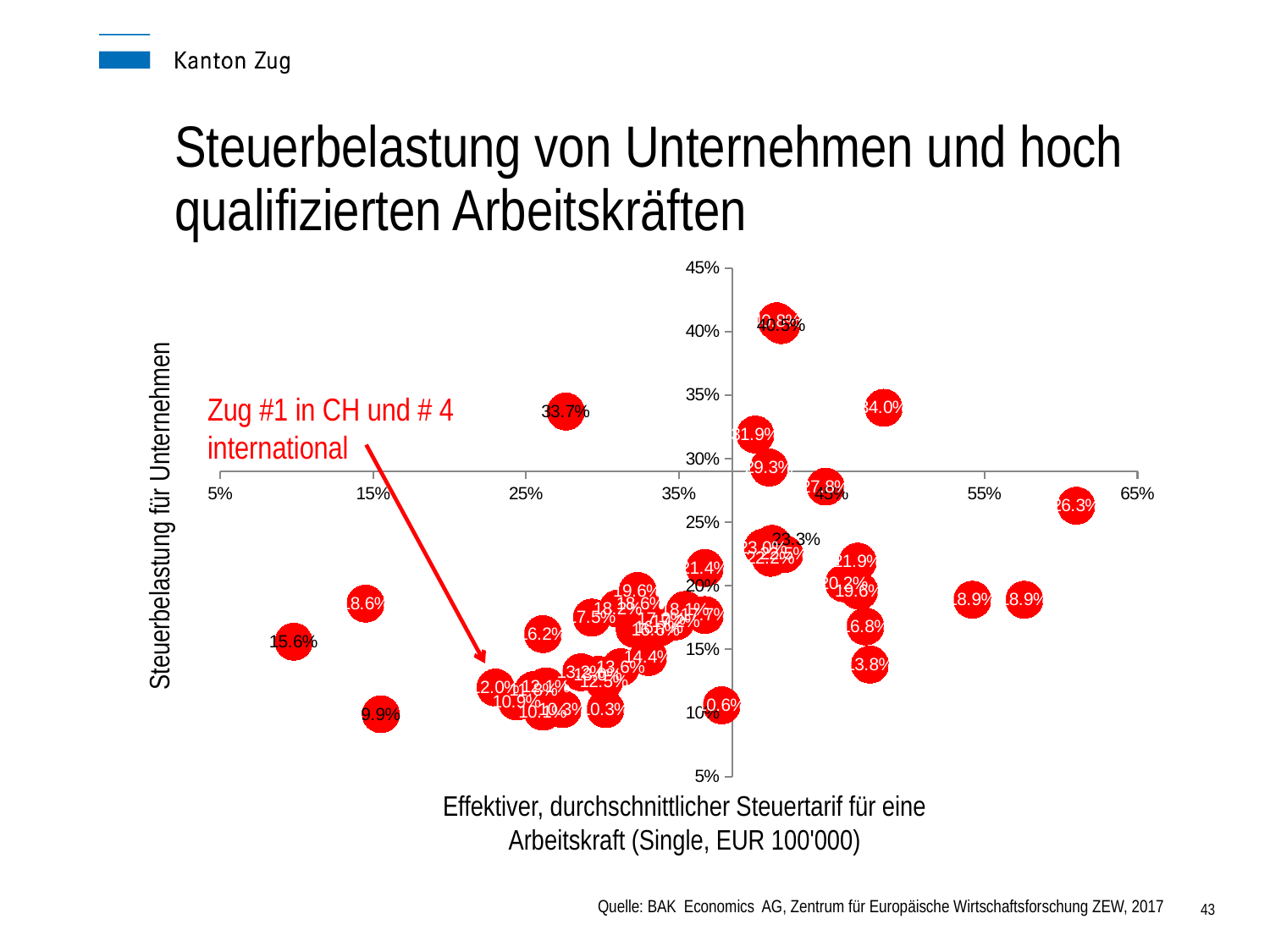
Is the x-axis value of the point labeled 34.0% greater or less than 45%? greater What is the lowest value printed as a data label on the chart? 9.9% Is the x-axis value of the point labeled 26.3% greater or less than 55%? greater What text does the red annotation on the chart say? Zug #1 in CH und # 4 international What is the highest value printed as a data label on the chart? 40.8% What is the title of the vertical axis? Steuerbelastung für Unternehmen What is the highest tick value shown on the vertical axis? 45% Which is larger, the point labeled 33.7% or the point labeled 34.0%? 34.0% Is the x-axis value of the point labeled 33.7% greater or less than 35%? less What is the difference between the highest labeled value (40.8%) and the lowest labeled value (9.9%)? 30.9 percentage points What kind of chart is shown on the slide? scatter chart